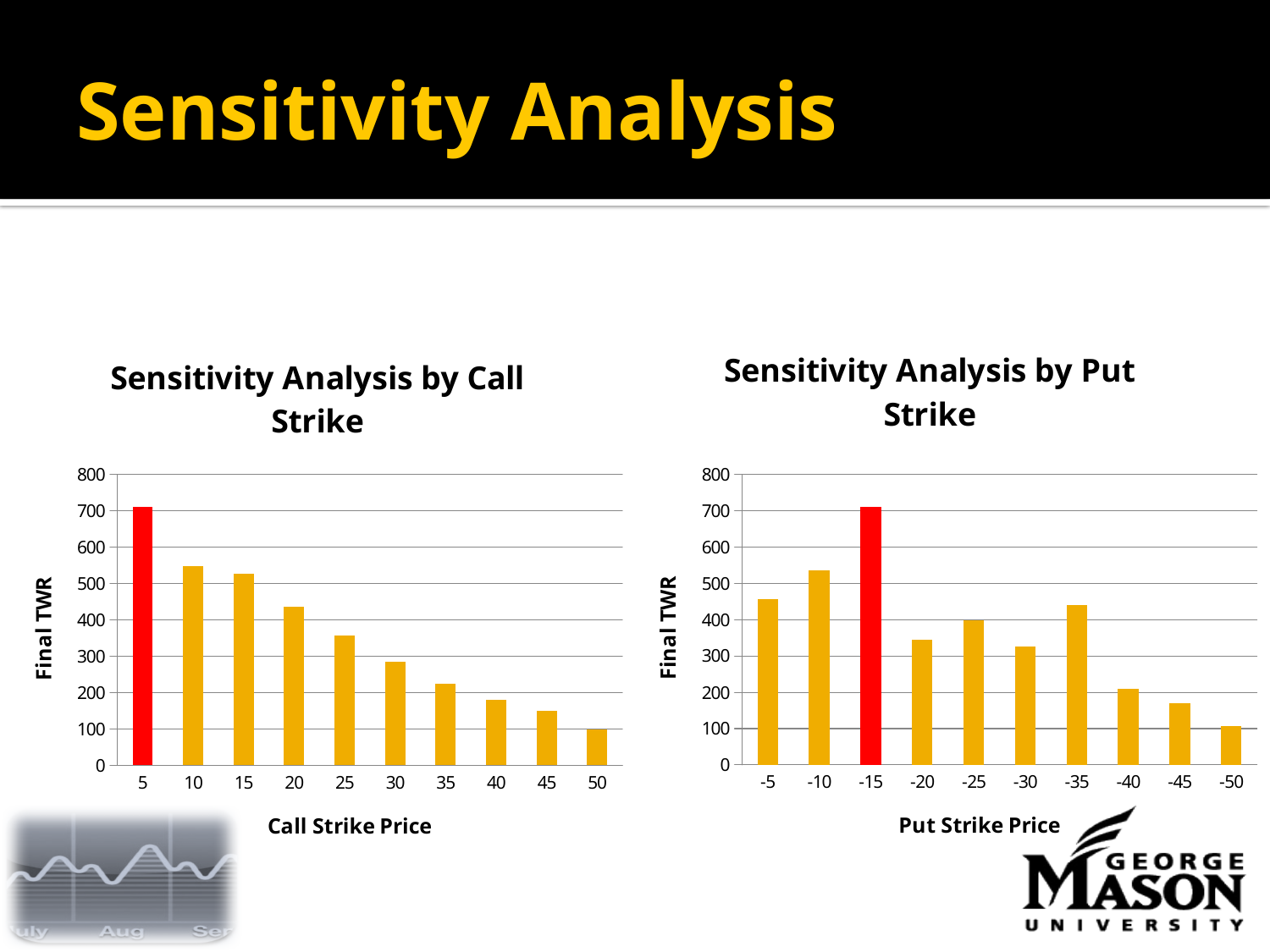
In the 'Sensitivity Analysis by Put Strike' chart, which put strike price has the lowest Final TWR? -50 What kind of chart is the 'Sensitivity Analysis by Put Strike' chart? Bar chart In the 'Sensitivity Analysis by Put Strike' chart, which put strike price has the highest Final TWR? -15 In the 'Sensitivity Analysis by Call Strike' chart, is the Final TWR for a call strike price of 20 greater or less than 400? greater In the 'Sensitivity Analysis by Call Strike' chart, do the Final TWR values rise or fall as the call strike price increases from 5 to 50? Fall In the 'Sensitivity Analysis by Call Strike' chart, which call strike price has the lowest Final TWR? 50 In the 'Sensitivity Analysis by Put Strike' chart, which put strike price's bar is coloured red? -15 In the 'Sensitivity Analysis by Put Strike' chart, is the Final TWR for a put strike price of -40 greater or less than 300? less How many call strike prices are plotted in the 'Sensitivity Analysis by Call Strike' chart? 10 In the 'Sensitivity Analysis by Put Strike' chart, which has the higher Final TWR: put strike price -5 or -10? -10 In the 'Sensitivity Analysis by Put Strike' chart, which has the higher Final TWR: put strike price -20 or -35? -35 In the 'Sensitivity Analysis by Call Strike' chart, which call strike price has the highest Final TWR? 5